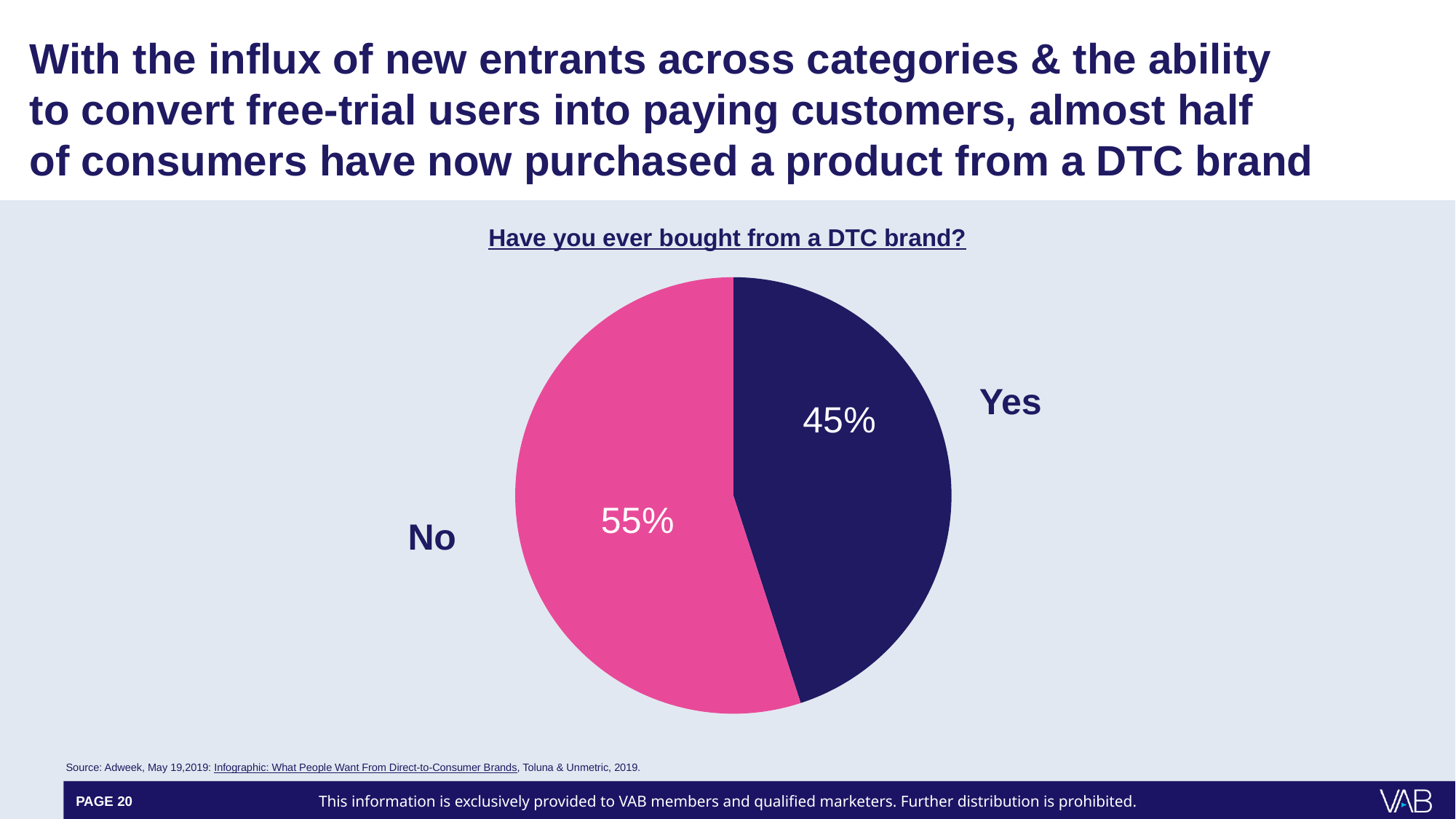
What is the difference in percentage points between the No and Yes slices? 10 Which response has the smaller share of the pie? Yes Which response has the larger share of the pie, Yes or No? No What colour is the Yes slice of the pie chart? dark navy blue What is the title of the chart? Have you ever bought from a DTC brand? Is the share for Yes larger or smaller than the share for No? smaller What percentage of respondents answered No to having bought from a DTC brand? 55% What share of the pie does the No slice represent? 55% What kind of chart is shown on the slide? pie chart How many slices does the pie chart have? 2 What percentage of respondents answered Yes to having bought from a DTC brand? 45%